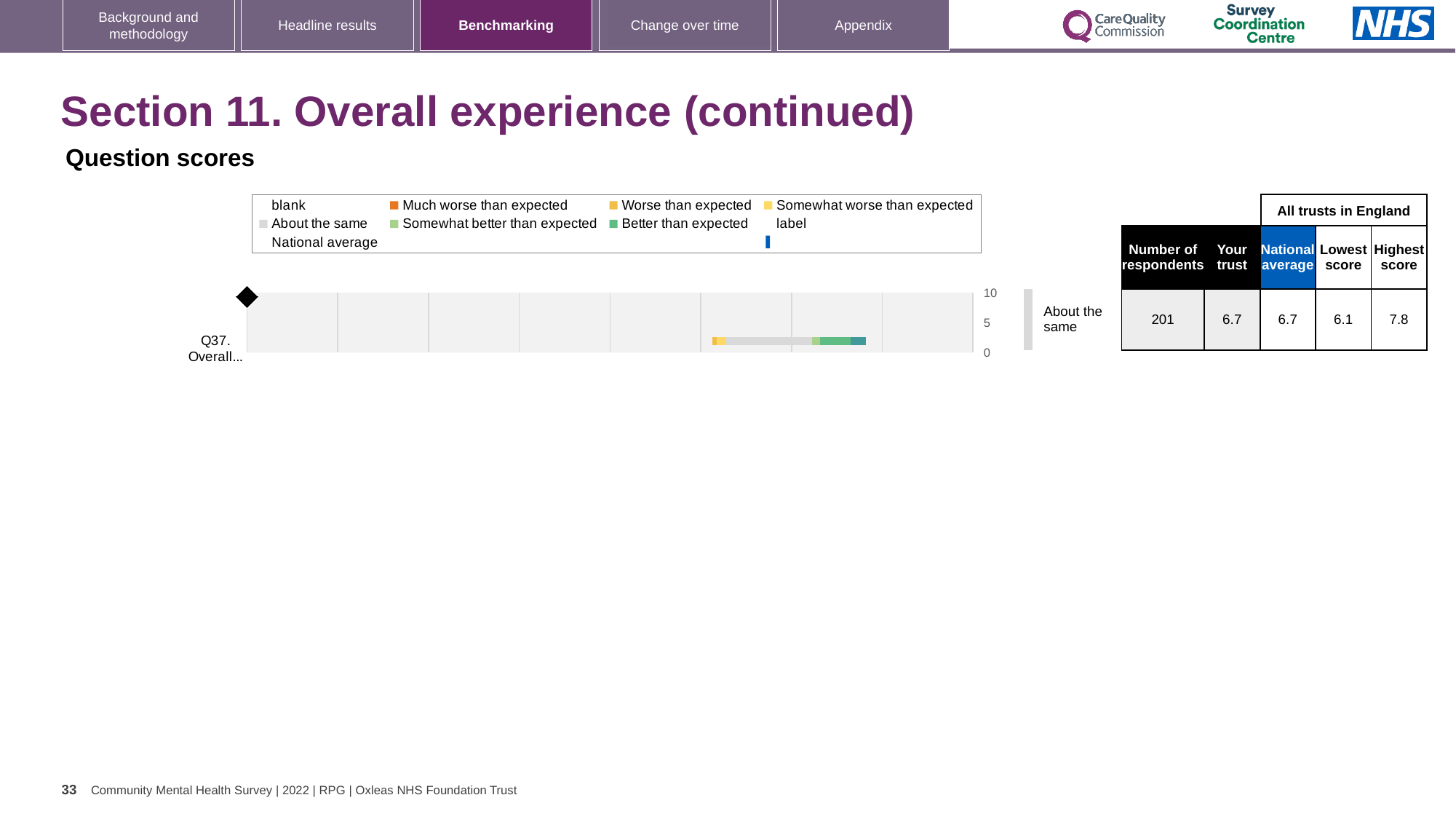
How is the trust's result for Q37 categorised in the label next to the chart? About the same According to the table next to the chart, what is the lowest score among all trusts in England for Q37? 6.1 According to the table next to the chart, what is the national average score for Q37? 6.7 What is the highest value shown on the chart's axis? 10 According to the table next to the chart, what is the highest score among all trusts in England for Q37? 7.8 How many question categories are plotted on the chart? 1 Is the 'Your trust' score for Q37 greater or less than 5? greater Which question is plotted on the chart? Q37. Overall... What is the difference between the highest score and the lowest score for Q37 in the table next to the chart? 1.7 What kind of chart is shown on the slide? bar chart According to the table next to the chart, how many respondents answered Q37? 201 According to the table next to the chart, what is the 'Your trust' score for Q37? 6.7